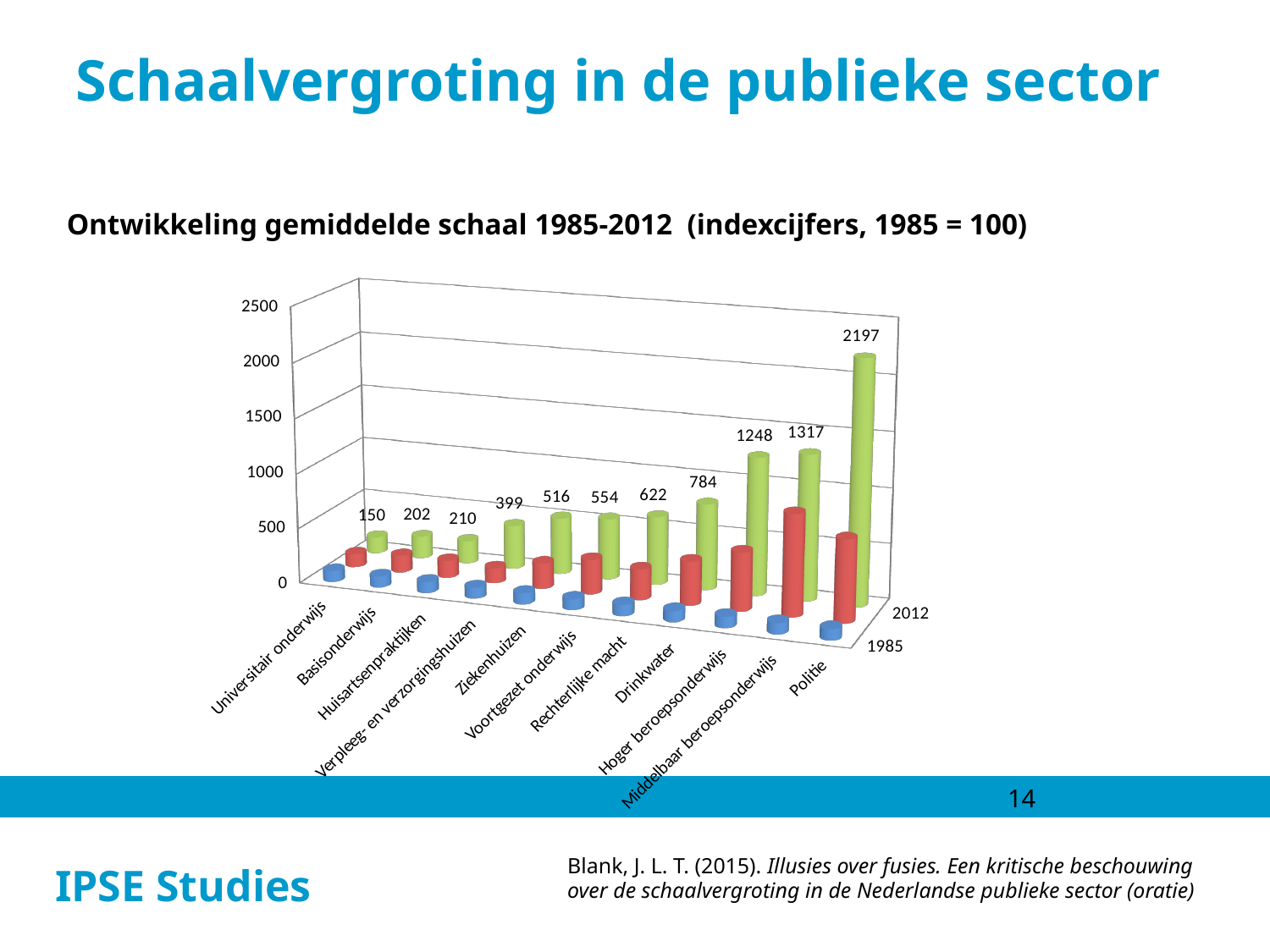
What kind of chart is shown on the slide? bar chart How many categories are shown on the x axis of the chart? 11 Which has a higher 2012 index value, Rechterlijke macht or Voortgezet onderwijs? Rechterlijke macht Do the 2012 index values rise or fall from Universitair onderwijs to Politie along the x axis? rise Is the 2012 index value for Basisonderwijs greater or less than 500? less What is the difference between the 2012 index values for Middelbaar beroepsonderwijs and Hoger beroepsonderwijs? 69 What is the 2012 index value for Verpleeg- en verzorgingshuizen? 399 What is the 2012 index value for Ziekenhuizen? 516 What is the 2012 index value for Politie? 2197 Which category has the lowest 2012 index value? Universitair onderwijs What is the 2012 index value for Drinkwater? 784 Which category has the highest 2012 index value? Politie